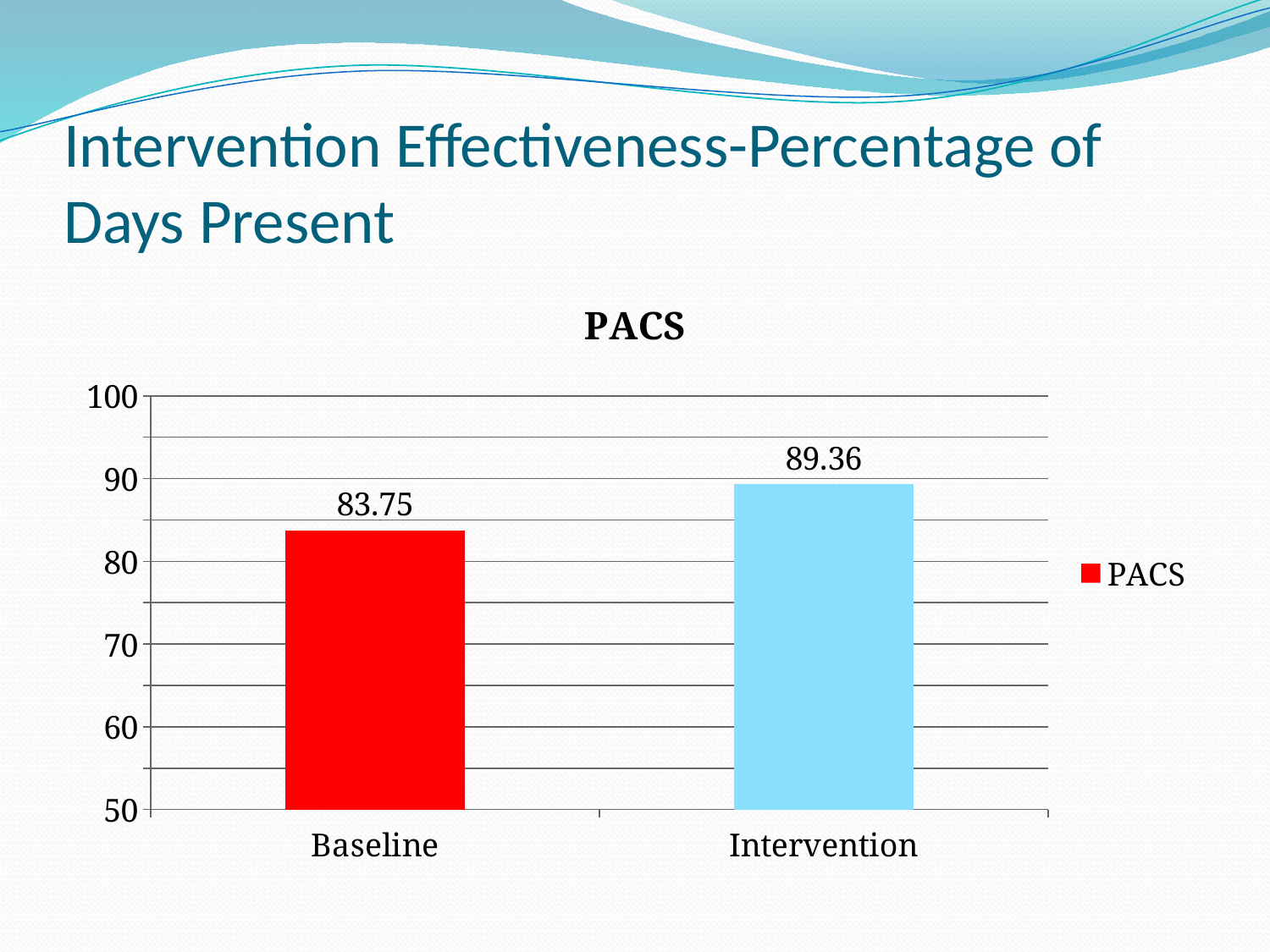
Which is larger, the value for Baseline or the value for Intervention? Intervention What kind of chart is shown? bar chart Which category has the highest value? Intervention What is the title of the chart? PACS What is the value for Intervention? 89.36 Which category has the lowest value? Baseline How many series does the legend list? 1 What is the value for Baseline? 83.75 Is the value for Intervention greater or less than 90? less What is the difference between the Intervention and Baseline values? 5.61 How many categories are shown on the x axis? 2 Is the value for Baseline greater or less than 80? greater